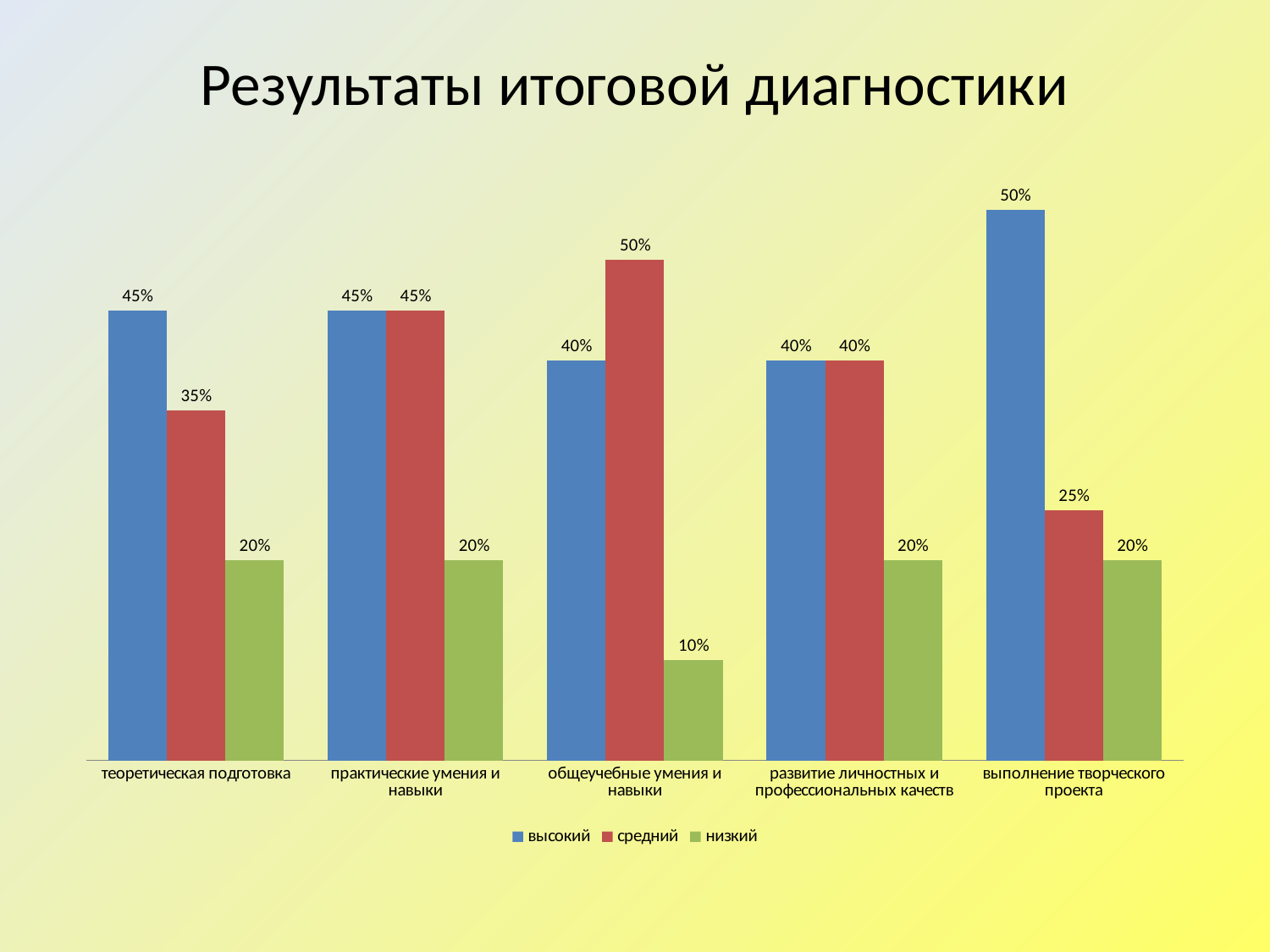
How many categories are shown on the x axis? 5 What is the value of the 'высокий' series for 'выполнение творческого проекта'? 50% What is the difference between the 'высокий' and 'средний' values for 'выполнение творческого проекта'? 25% What type of chart is shown on the slide? bar chart Which series is shown in green in the legend? низкий Which category has the lowest value for the 'низкий' series? общеучебные умения и навыки What is the value of the 'низкий' series for 'общеучебные умения и навыки'? 10% What is the value of the 'средний' series for 'теоретическая подготовка'? 35% How many series does the legend list? 3 For 'общеучебные умения и навыки', which is larger: the 'высокий' value or the 'средний' value? средний What is the title of the chart? Результаты итоговой диагностики Which category has the highest value for the 'средний' series? общеучебные умения и навыки